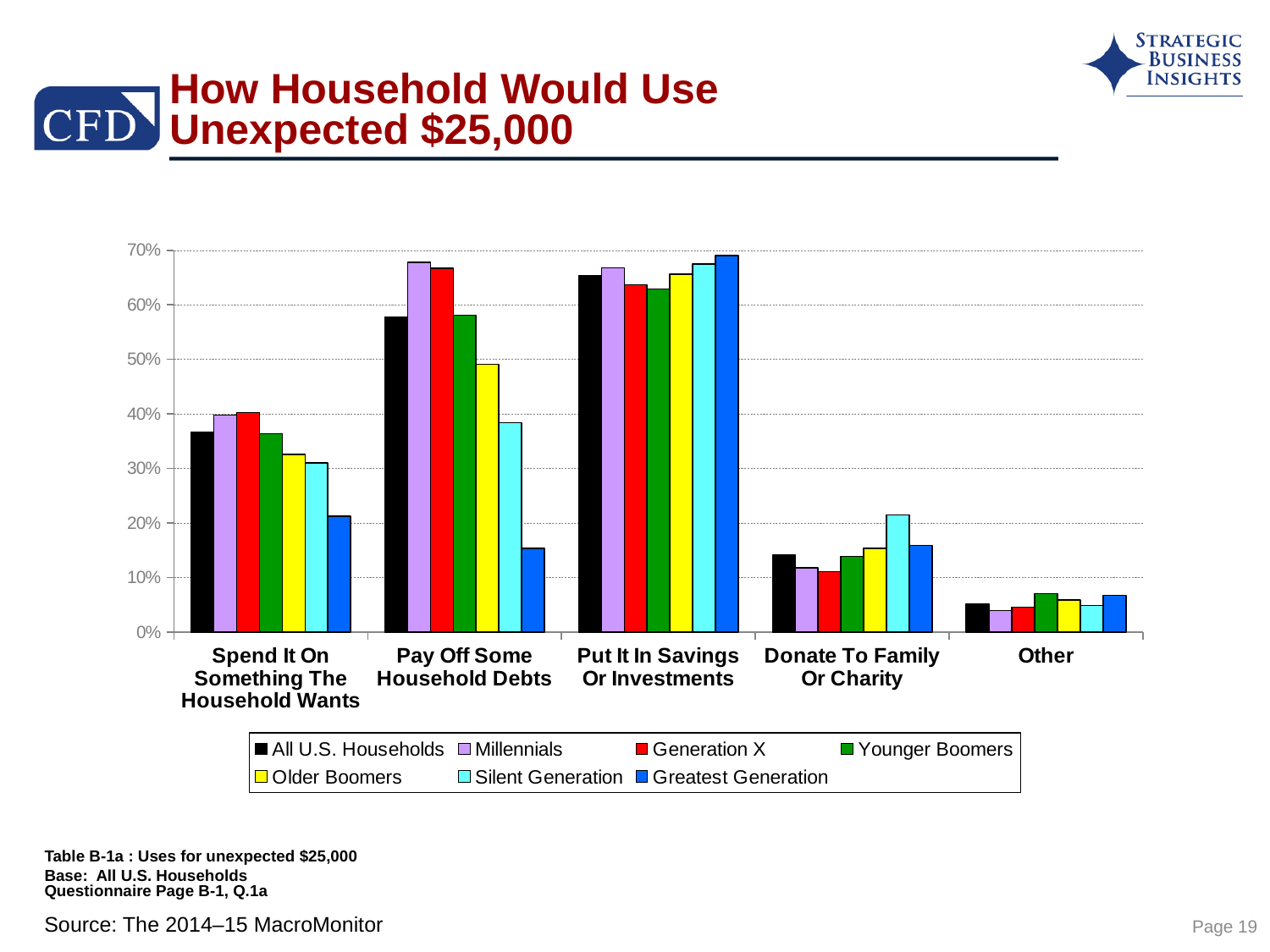
How many categories are shown along the x axis of the chart? 5 How many series does the chart's legend list? 7 What kind of chart is shown on the slide? bar chart Within the Pay Off Some Household Debts category, which series has the lowest value? Greatest Generation Is the value for All U.S. Households in the Put It In Savings Or Investments category greater or less than 60%? greater Is the value for Greatest Generation in the Pay Off Some Household Debts category greater or less than 20%? less Is the value for Millennials in the Pay Off Some Household Debts category greater or less than 60%? greater In the Pay Off Some Household Debts category, which is larger: the value for Older Boomers or the value for Silent Generation? Older Boomers What is the title of the chart on the slide? How Household Would Use Unexpected $25,000 What colour represents Generation X in the chart's legend? red In the Spend It On Something The Household Wants category, which is larger: the value for Millennials or the value for Greatest Generation? Millennials Within the Donate To Family Or Charity category, which series has the highest value? Silent Generation